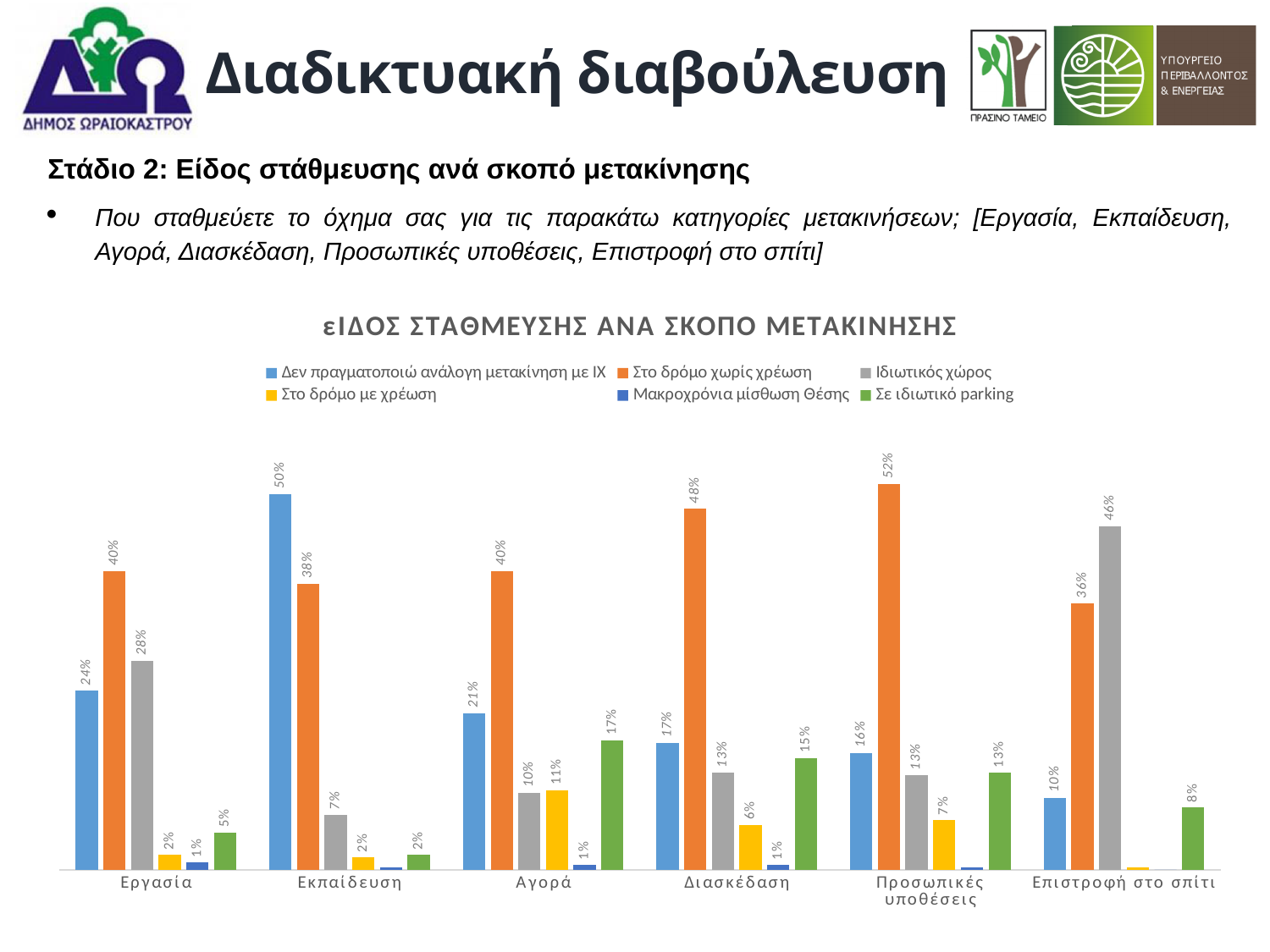
What is the value for 'Στο δρόμο χωρίς χρέωση' in the 'Εργασία' category? 40% What is the difference between 'Στο δρόμο χωρίς χρέωση' and 'Ιδιωτικός χώρος' in the 'Διασκέδαση' category? 35% What is the value for 'Δεν πραγματοποιώ ανάλογη μετακίνηση με ΙΧ' in the 'Εκπαίδευση' category? 50% How many series does the legend list? 6 What type of chart is shown on the slide? bar chart In which category does 'Δεν πραγματοποιώ ανάλογη μετακίνηση με ΙΧ' have its lowest value? Επιστροφή στο σπίτι What is the title of the chart? εΙΔΟΣ ΣΤΑΘΜΕΥΣΗΣ ΑΝΑ ΣΚΟΠΟ ΜΕΤΑΚΙΝΗΣΗΣ In which category does 'Στο δρόμο χωρίς χρέωση' reach its highest value? Προσωπικές υποθέσεις How many categories are shown on the x axis? 6 What is the value for 'Σε ιδιωτικό parking' in the 'Αγορά' category? 17% In the 'Αγορά' category, which is larger: 'Ιδιωτικός χώρος' or 'Στο δρόμο με χρέωση'? Στο δρόμο με χρέωση What is the value for 'Ιδιωτικός χώρος' in the 'Επιστροφή στο σπίτι' category? 46%